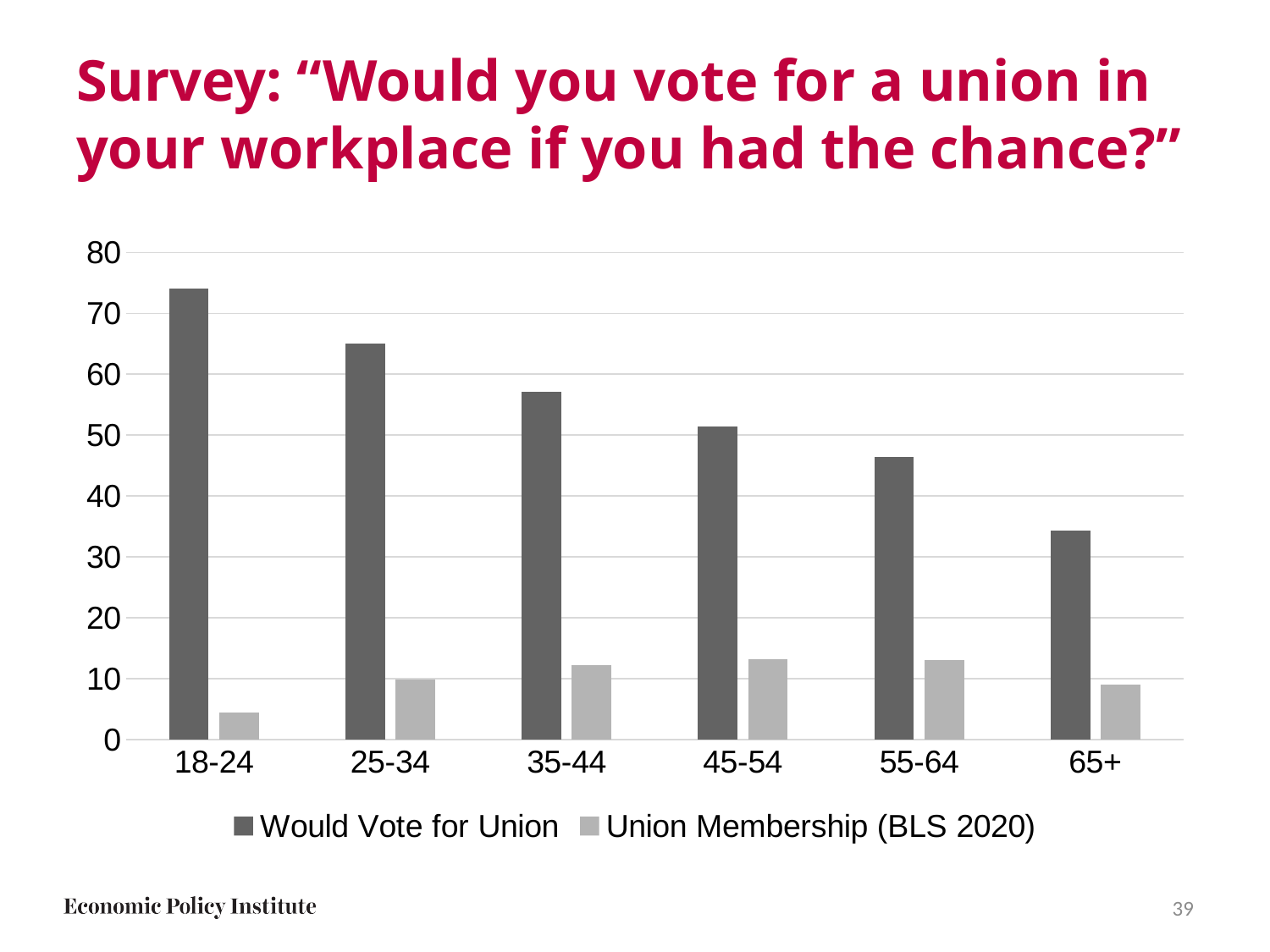
Is the Union Membership (BLS 2020) value for 18-24 greater or less than 10? less Which age group has the highest value for Would Vote for Union? 18-24 Is the Would Vote for Union value for 65+ greater or less than 40? less Is the Would Vote for Union value for 18-24 greater or less than 70? greater Which age group has the lowest value for Would Vote for Union? 65+ Do the Would Vote for Union values rise or fall as age increases along the x axis? fall How many age groups are shown on the x axis? 6 Which is larger for the 25-34 age group: Would Vote for Union or Union Membership (BLS 2020)? Would Vote for Union How many series does the legend list? 2 Which age group has the lowest value for Union Membership (BLS 2020)? 18-24 What kind of chart is shown on the slide? bar chart